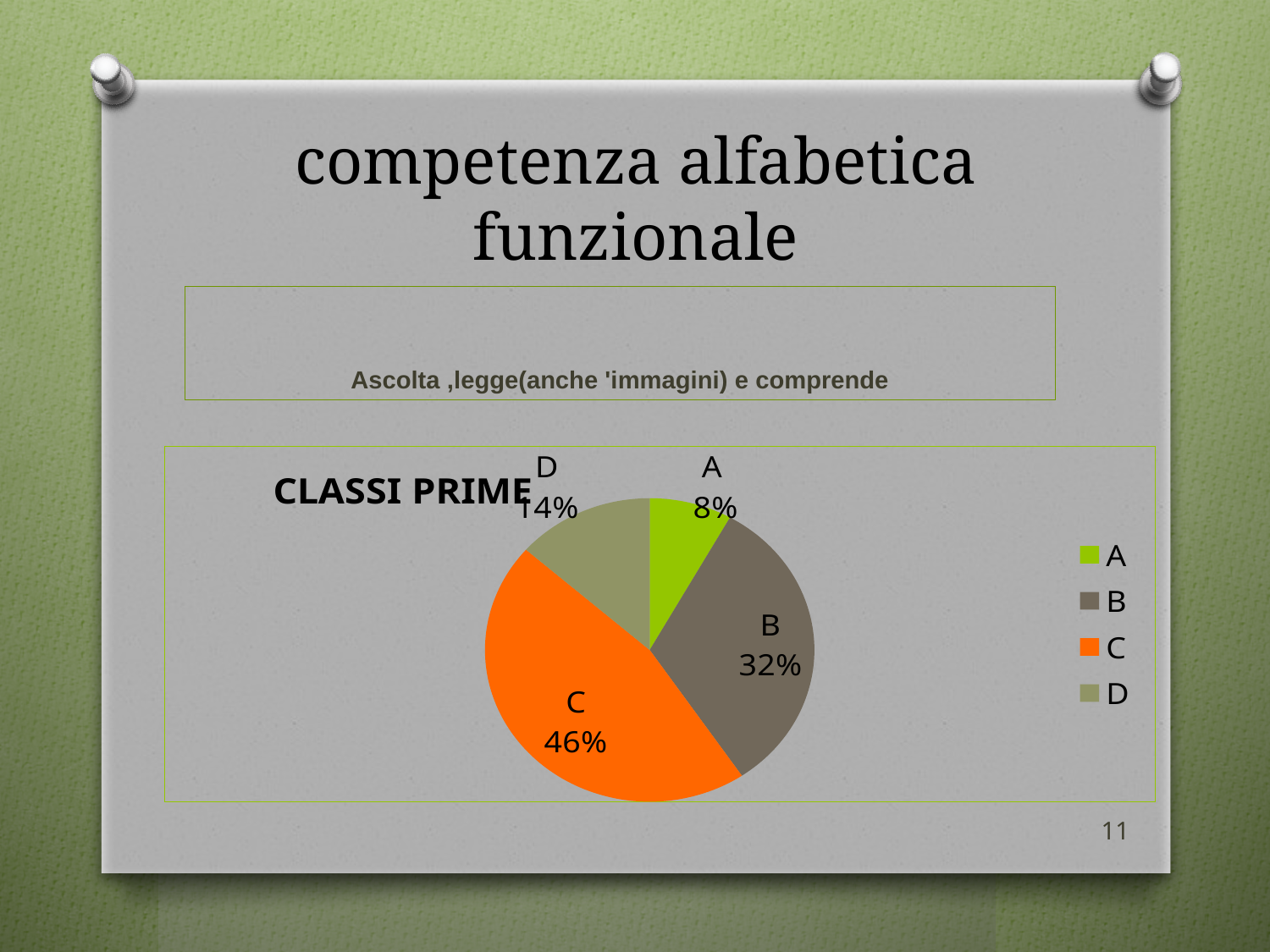
What percentage does slice B represent? 32% How many categories does the legend list? 4 What is the title of the chart? CLASSI PRIME What percentage does slice D represent? 14% What percentage does slice A represent? 8% What colour is the slice for category C? orange Which category has the smallest share of the pie? A Which is larger, the share for D or the share for A? D What is the difference in percentage points between C and B? 14 What type of chart is shown on the slide? pie chart What percentage does slice C represent? 46% Which category has the largest share of the pie? C